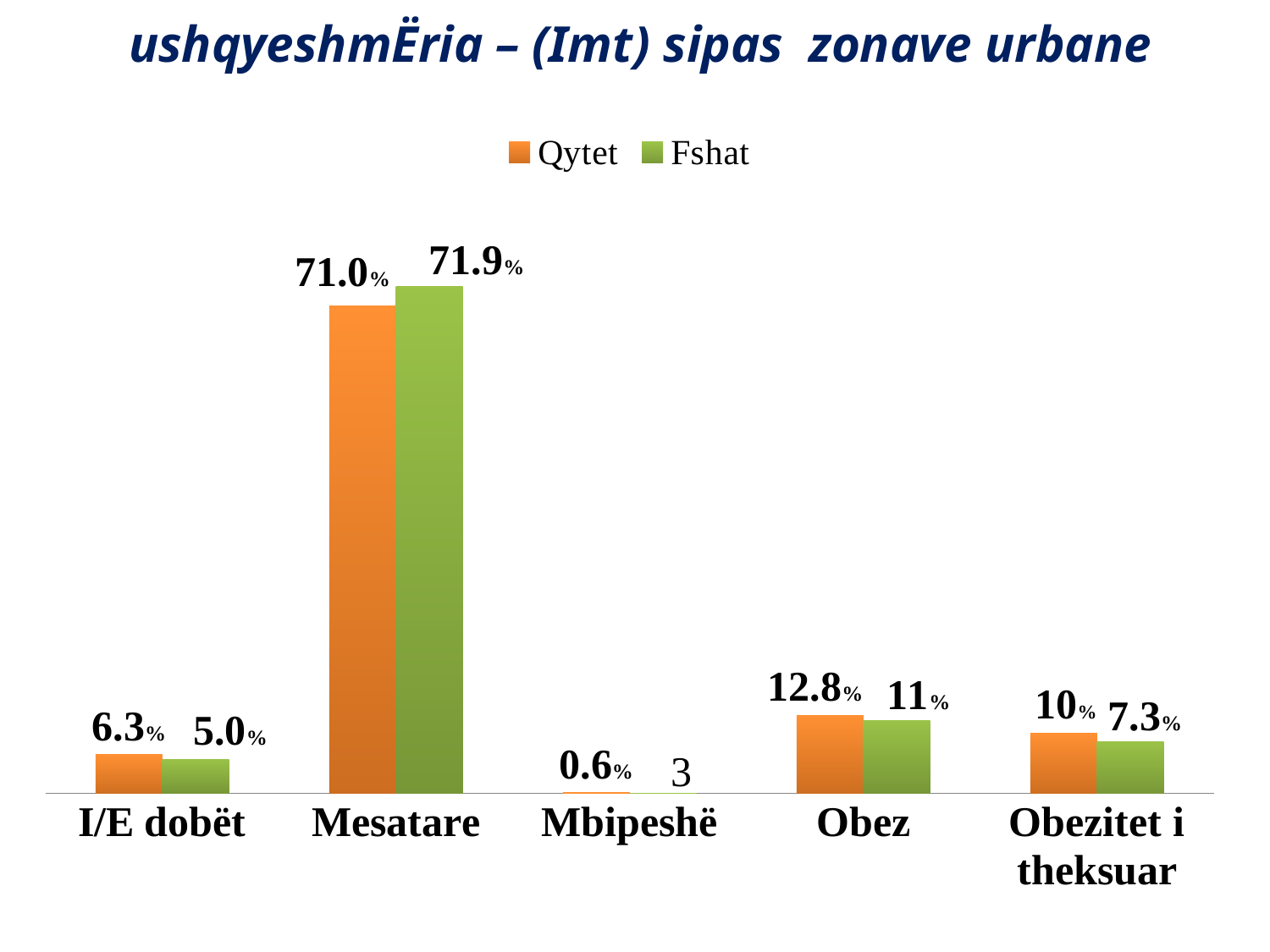
What is the Fshat value for Obezitet i theksuar? 7.3% Which category has the highest Qytet value? Mesatare What type of chart is shown on the slide? bar chart What is the Fshat value for Mesatare? 71.9% Which series is shown in orange in the legend? Qytet How many series does the legend list? 2 What is the Qytet value for Mesatare? 71.0% How many categories are shown on the x axis? 5 Which category has the lowest Qytet value? Mbipeshë What is the Qytet value for Obez? 12.8% What is the Qytet value for I/E dobët? 6.3% What is the difference between the Qytet and Fshat values for Obez? 1.8%